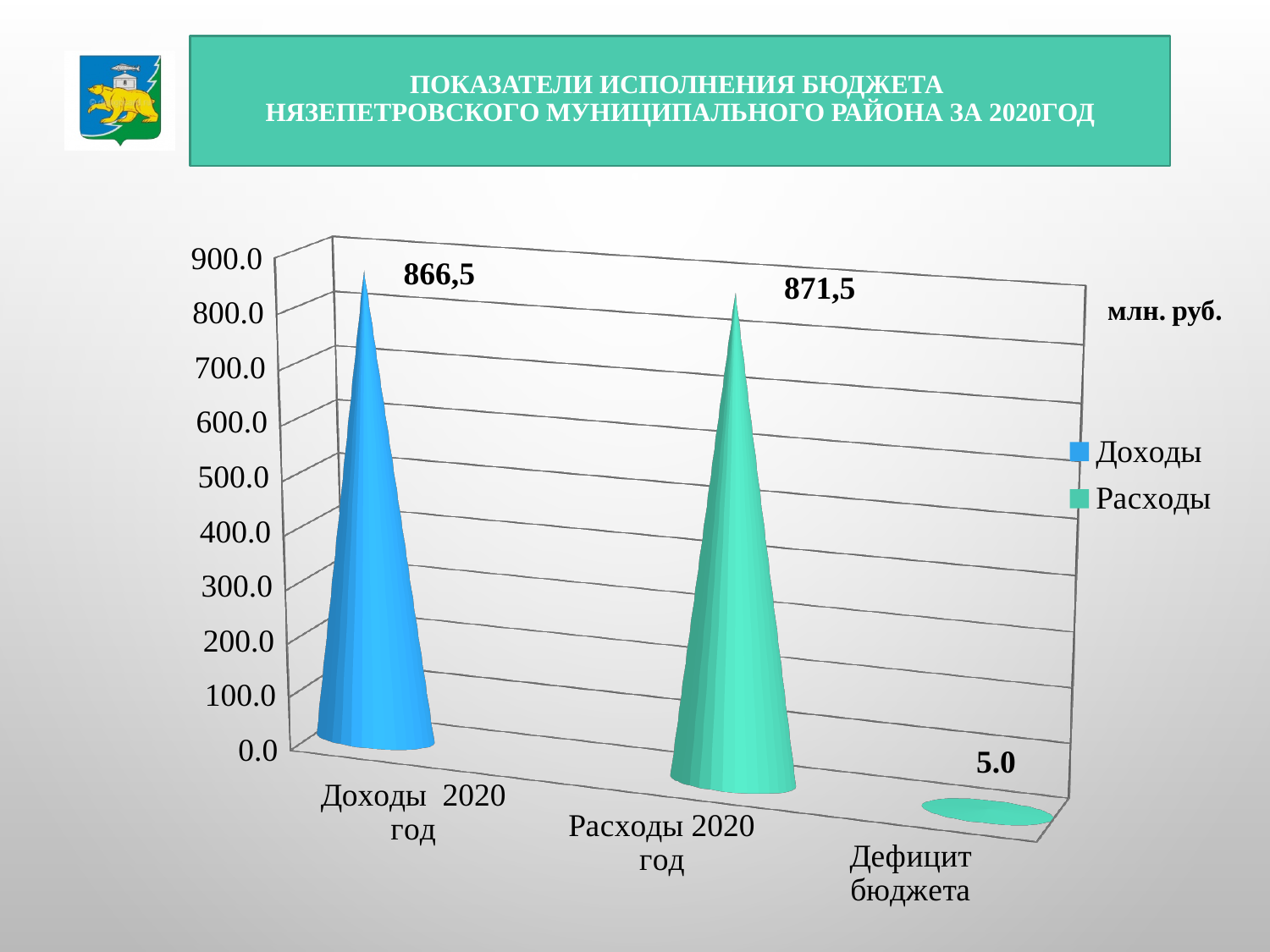
How many categories are shown on the x axis of the chart? 3 What unit of measurement is indicated next to the chart? млн. руб. How many series does the legend list? 2 What is the value shown for Доходы 2020 год? 866,5 Which category has the lowest value? Дефицит бюджета What is the difference between the values for Расходы 2020 год and Доходы 2020 год? 5,0 Is the value for Доходы 2020 год greater or less than 800.0? greater What is the value shown for Дефицит бюджета? 5.0 Which is larger, the value for Доходы 2020 год or the value for Расходы 2020 год? Расходы 2020 год Which category has the highest value? Расходы 2020 год What kind of chart is shown on the slide? bar chart What is the value shown for Расходы 2020 год? 871,5